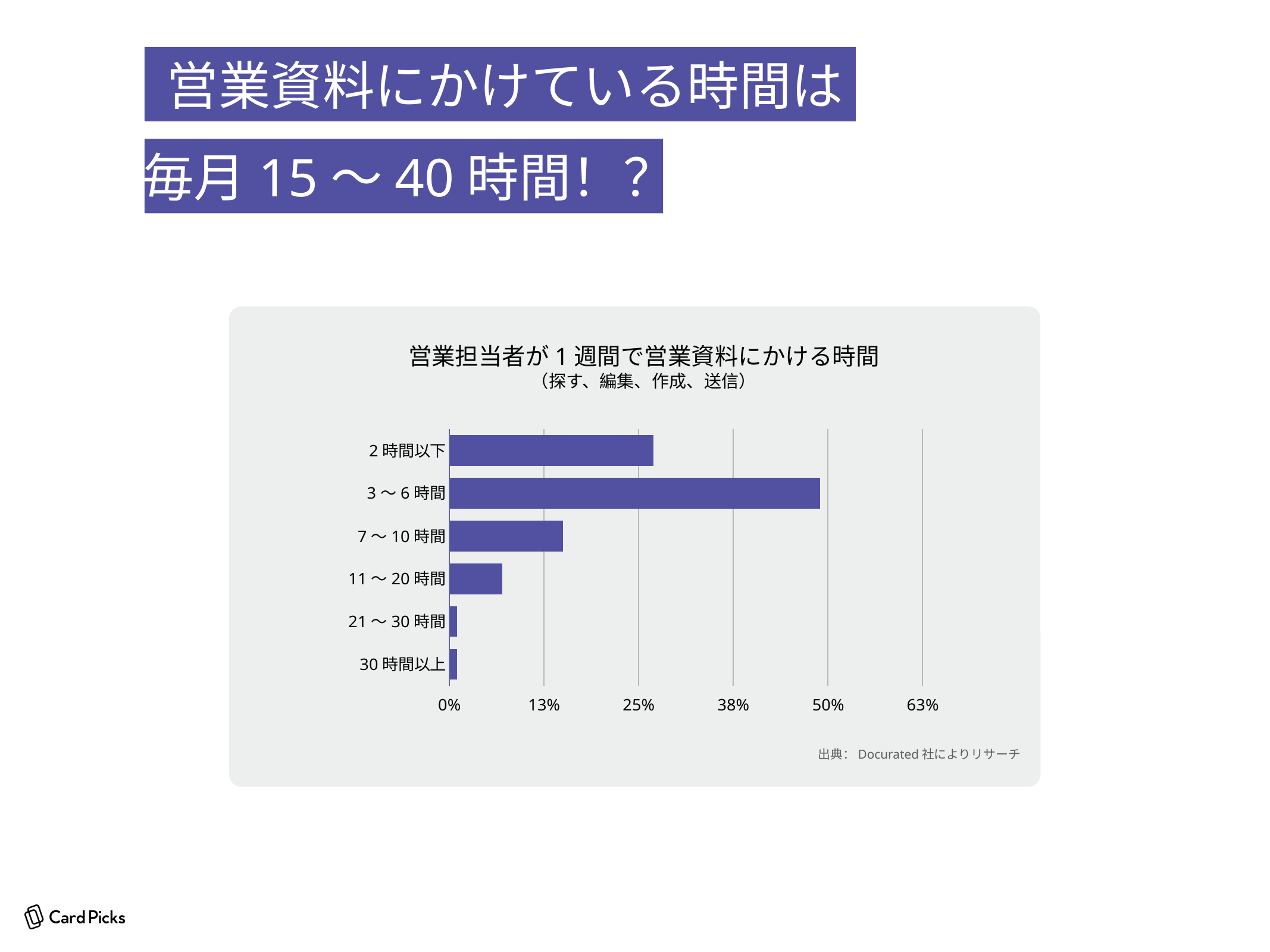
Is the value for 11〜20時間 greater or less than 13%? less Which category has the highest value in the chart? 3〜6時間 Is the value for 3〜6時間 greater or less than 38%? greater What is the title of the chart? 営業担当者が1週間で営業資料にかける時間（探す、編集、作成、送信） Which is larger, the value for 3〜6時間 or the value for 11〜20時間? 3〜6時間 What kind of chart is shown on the slide? bar chart Is the value for 7〜10時間 greater or less than 25%? less From 3〜6時間 down to 30時間以上, do the bar values rise or fall? fall How many categories are shown in the chart? 6 Which is larger, the value for 2時間以下 or the value for 7〜10時間? 2時間以下